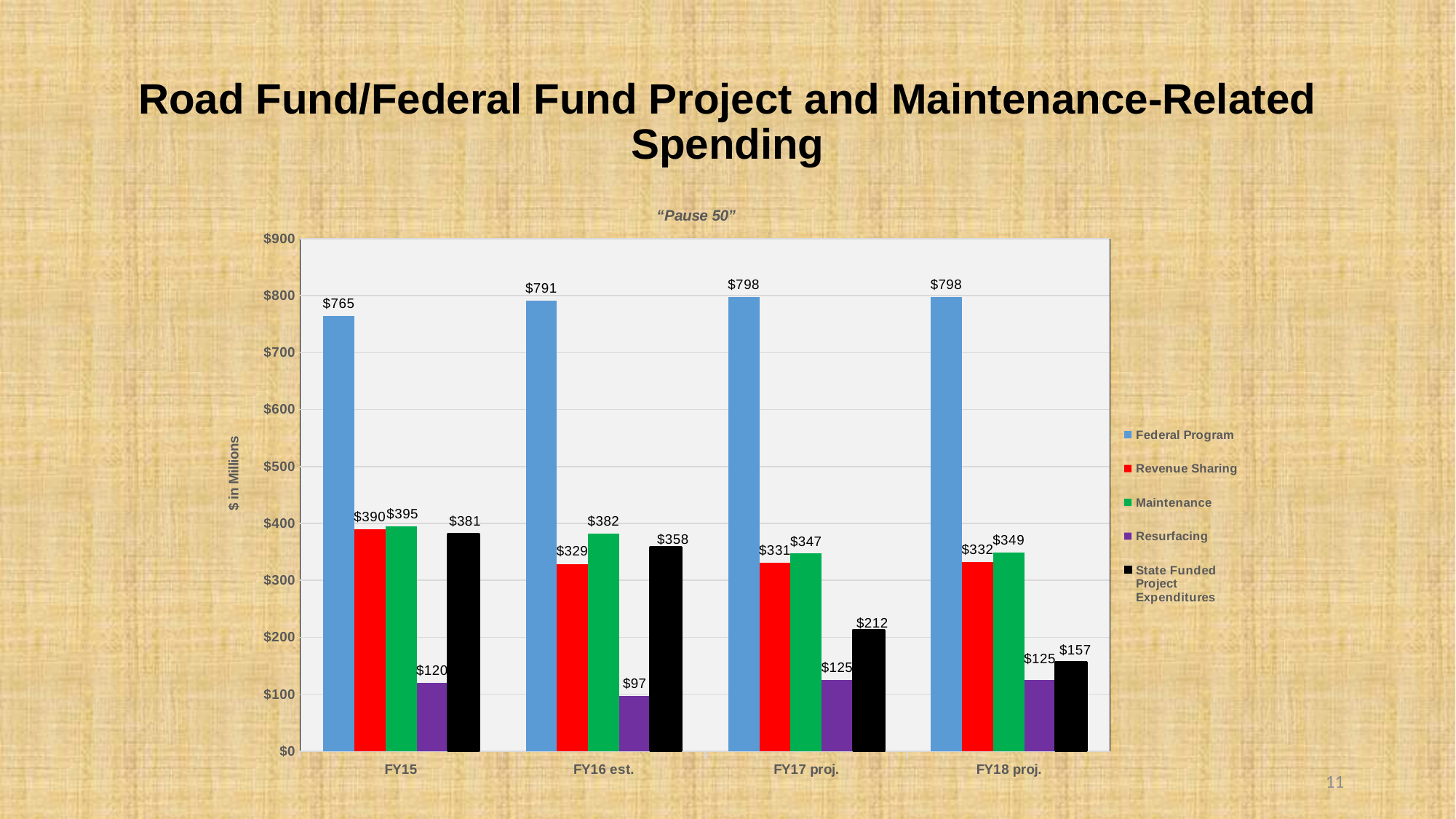
Which fiscal year has the lowest Resurfacing value? FY16 est. What is the value for Resurfacing in FY16 est.? $97 Which fiscal year has the highest State Funded Project Expenditures value? FY15 What is the value for Federal Program in FY15? $765 How many series does the legend list? 5 What is the difference between Federal Program in FY16 est. and FY15? $26 What kind of chart is shown on the slide? Bar chart Which is larger in FY15: Revenue Sharing or Maintenance? Maintenance What is the label on the vertical axis? $ in Millions How many fiscal year categories are shown on the x axis? 4 What is the value for State Funded Project Expenditures in FY17 proj.? $212 What is the value for Maintenance in FY18 proj.? $349